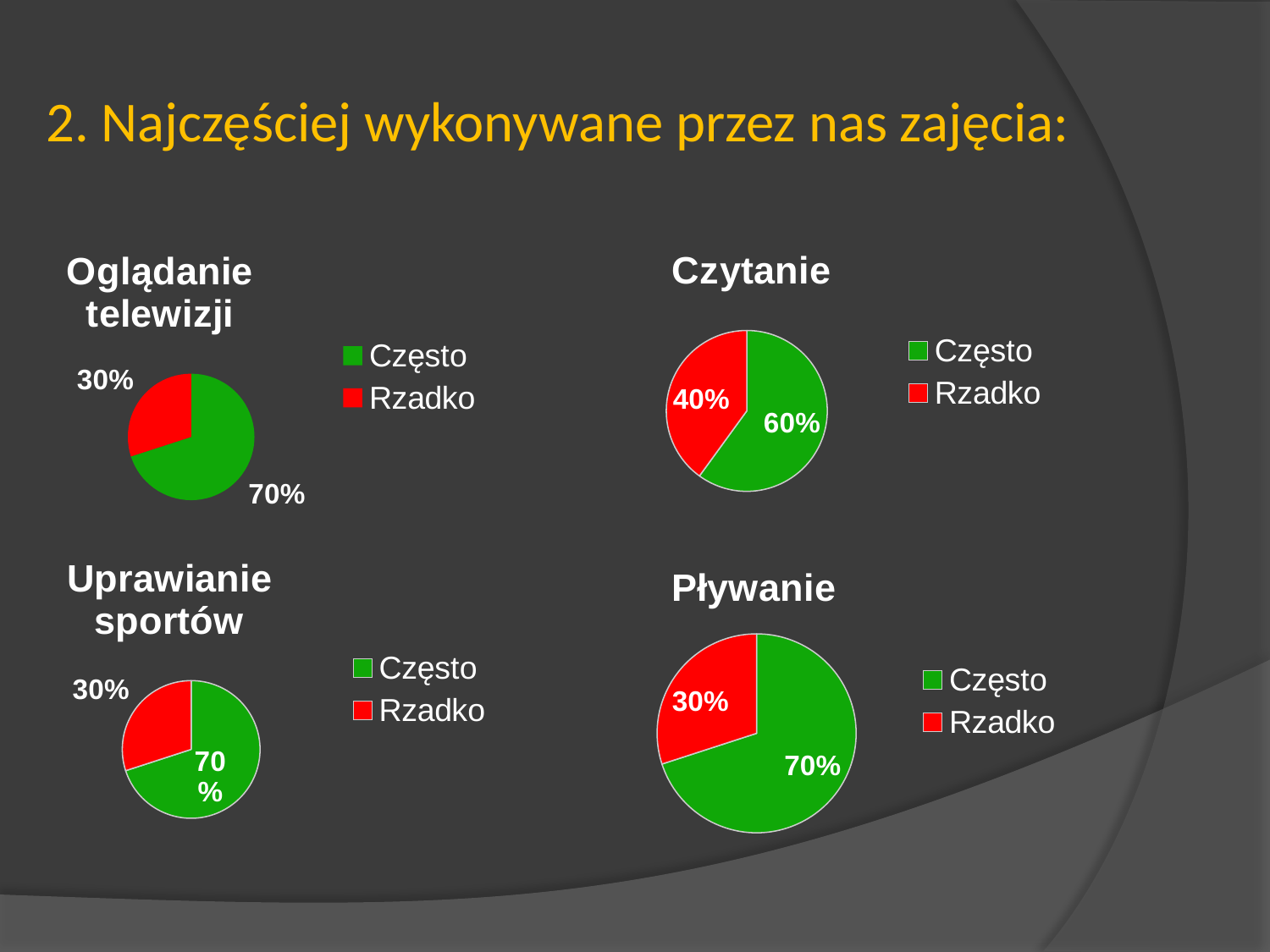
How many charts are shown on the slide? 4 In the 'Pływanie' chart, what is the value for Rzadko? 30% In the 'Pływanie' chart, which slice is the smallest? Rzadko In the 'Oglądanie telewizji' chart, which is larger, Często or Rzadko? Często In the 'Oglądanie telewizji' chart, what is the value for Często? 70% In the 'Czytanie' chart, what is the value for Rzadko? 40% What kind of chart is the 'Pływanie' chart? Pie chart In the 'Czytanie' chart, what is the difference between the Często and Rzadko values? 20% In the 'Czytanie' chart, which slice is the largest? Często In the 'Oglądanie telewizji' chart, what is the value for Rzadko? 30% In the 'Czytanie' chart, what is the value for Często? 60% In the 'Uprawianie sportów' chart, what is the value for Często? 70%